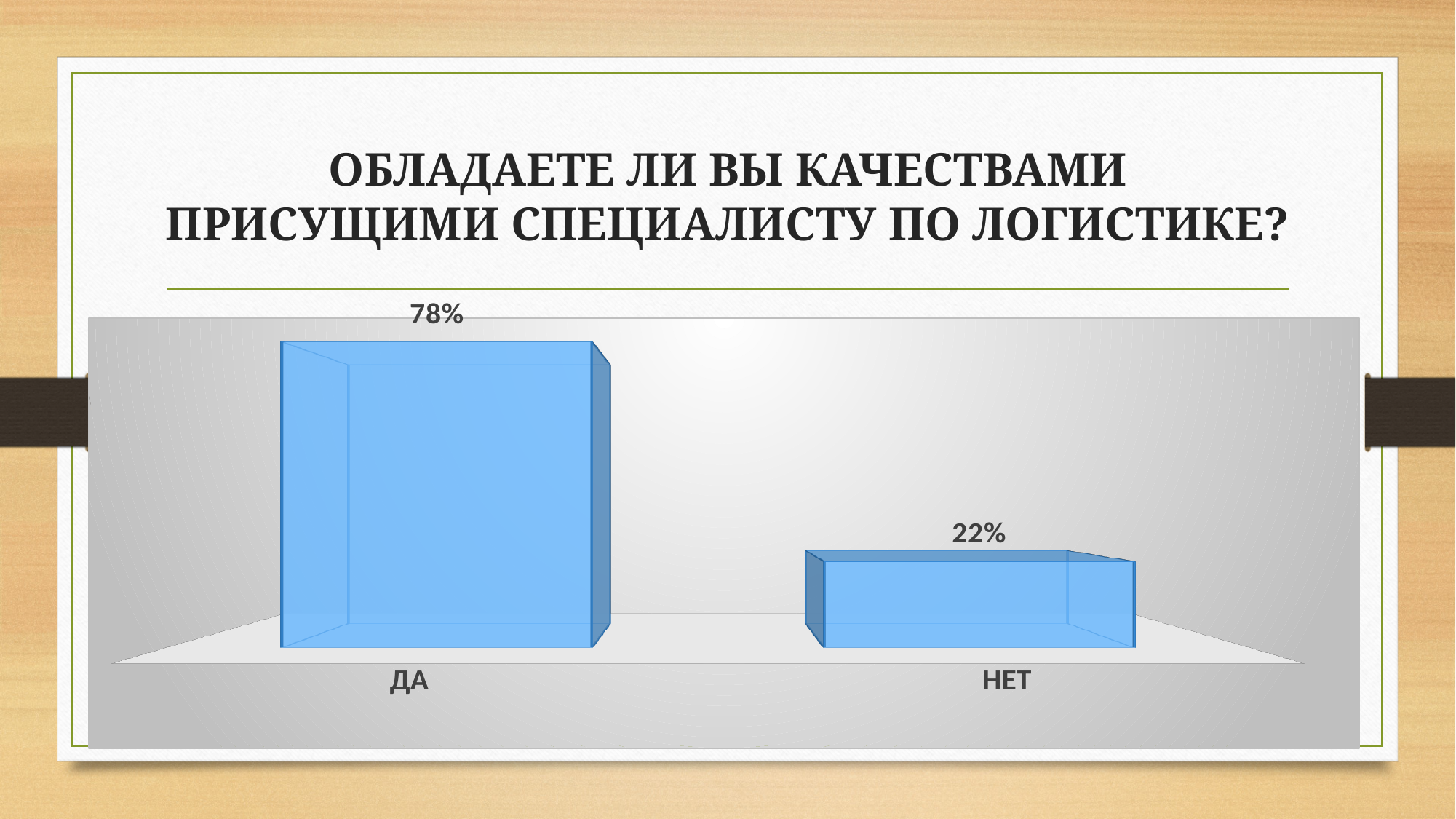
What is the value for ДА? 78% Which category has the highest value? ДА How many categories are shown in the chart? 2 Which category has the lowest value? НЕТ What question does the slide title ask? ОБЛАДАЕТЕ ЛИ ВЫ КАЧЕСТВАМИ ПРИСУЩИМИ СПЕЦИАЛИСТУ ПО ЛОГИСТИКЕ? Which is larger, the value for ДА or the value for НЕТ? ДА What is the total of the values for ДА and НЕТ? 100% What is the difference between the values for ДА and НЕТ? 56% What colour are the bars in the chart? Blue What kind of chart is shown on the slide? Bar chart What is the value for НЕТ? 22%